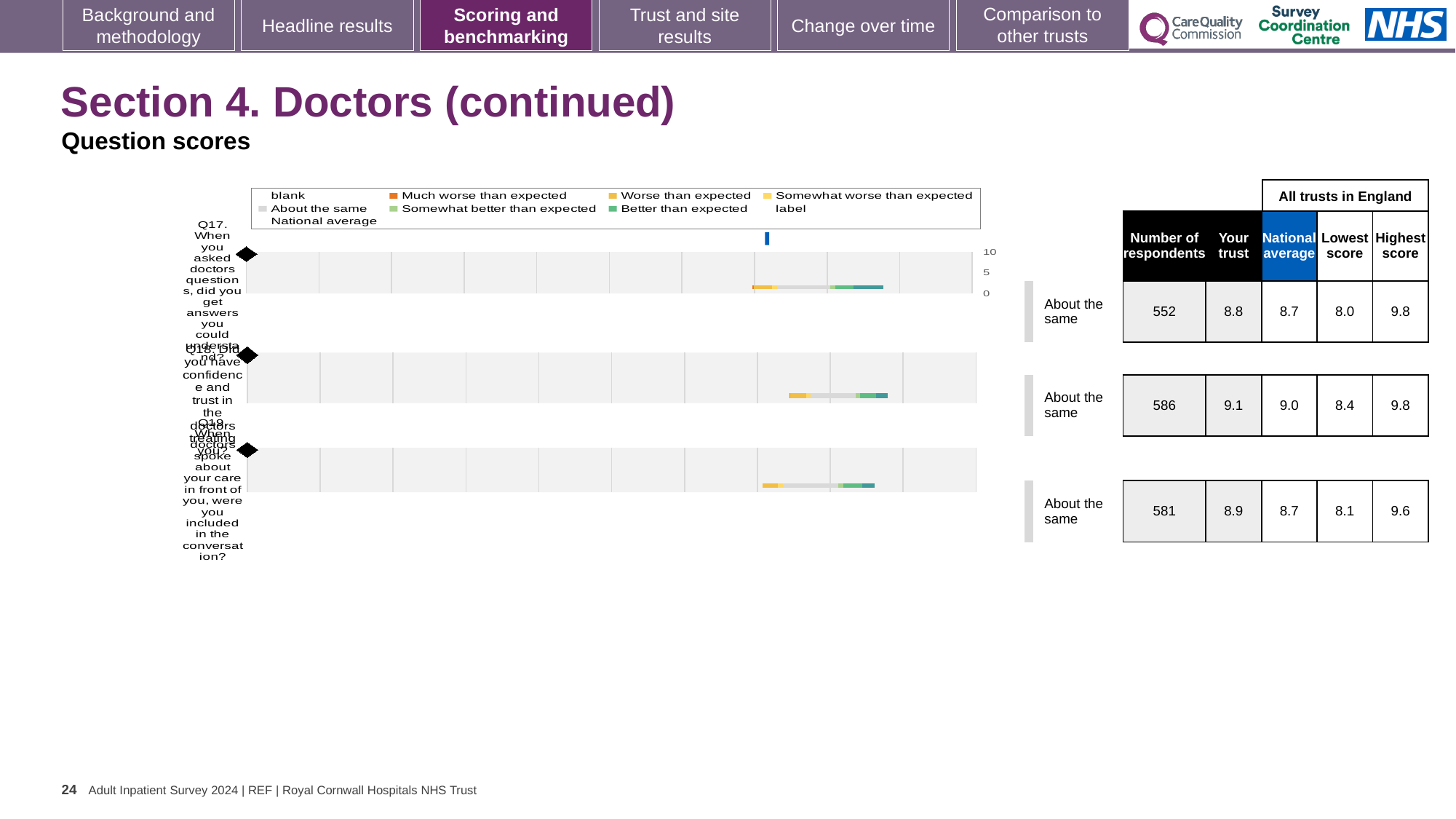
Is the 'Your trust' marker for Q17 on the chart greater or less than 5? greater What is the difference between the highest score and the lowest score for Q18? 1.4 What is the national average score for Q18? 9.0 What is the highest score across all trusts in England for Q19? 9.6 How many questions (categories) are plotted in the chart? 3 What kind of chart is shown on the slide? bar chart Which is larger, the 'Your trust' score for Q17 or for Q19? Q19 What benchmark category is shown for Q18 beside the chart? About the same How many respondents answered Q19? 581 Which question has the fewest respondents? Q17 Which question has the highest 'Your trust' score? Q18 What is the 'Your trust' score for Q17 in the table next to the chart? 8.8